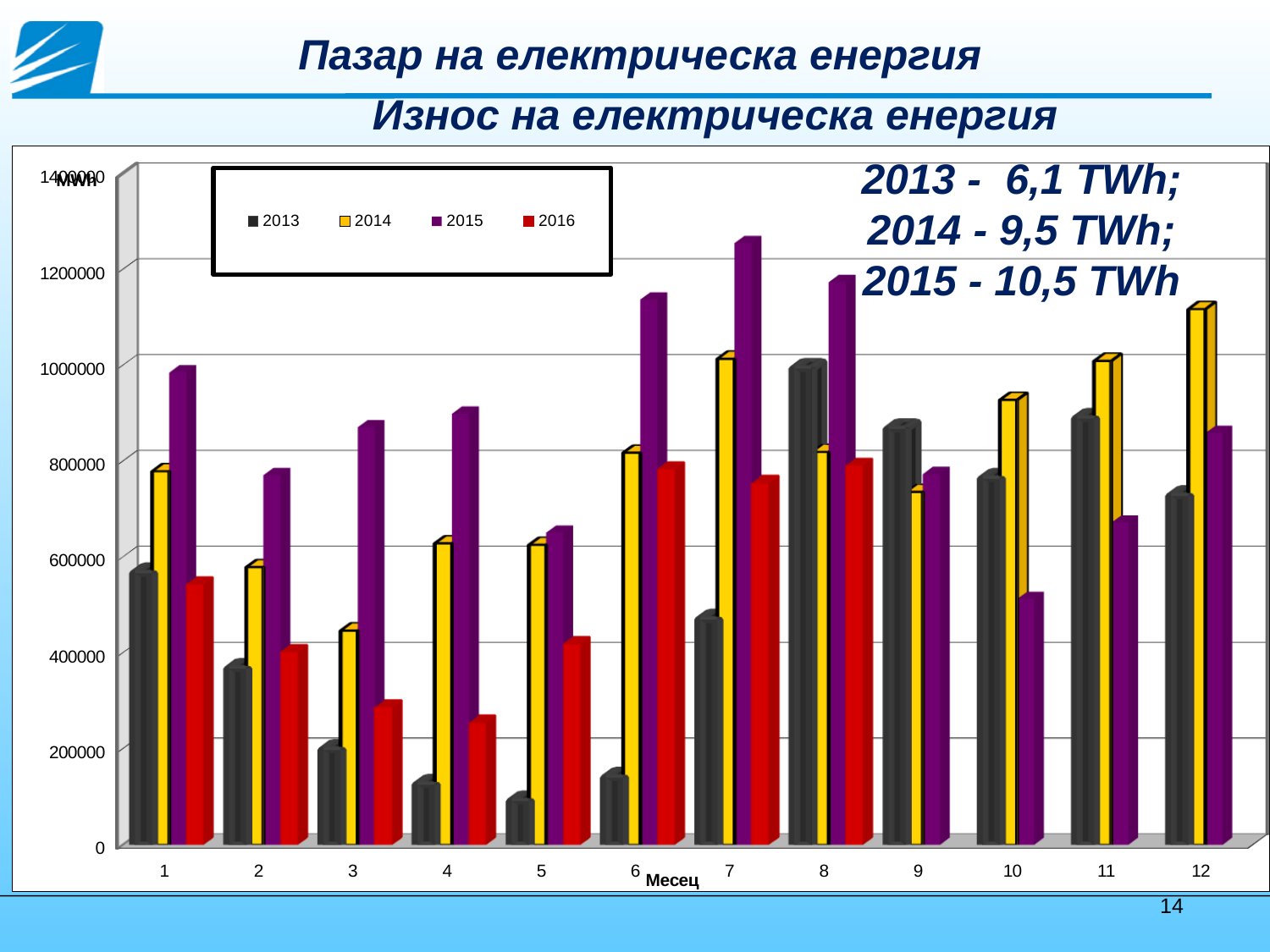
Is the 2013 value for month 5 greater or less than 200000? less For how many months are 2016 values plotted? 8 In month 10, which is larger: the 2014 value or the 2015 value? 2014 What kind of chart is shown on the slide? bar chart In month 1, which is larger: the 2013 value or the 2015 value? 2015 What unit is shown on the y axis? MWh In which month is the 2013 value the lowest? 5 Is the 2015 value for month 7 greater or less than 1200000? greater Which series are listed in the legend? 2013, 2014, 2015, 2016 How many series does the legend list? 4 In which month is the 2015 value the highest? 7 How many months (categories) are shown on the x axis? 12